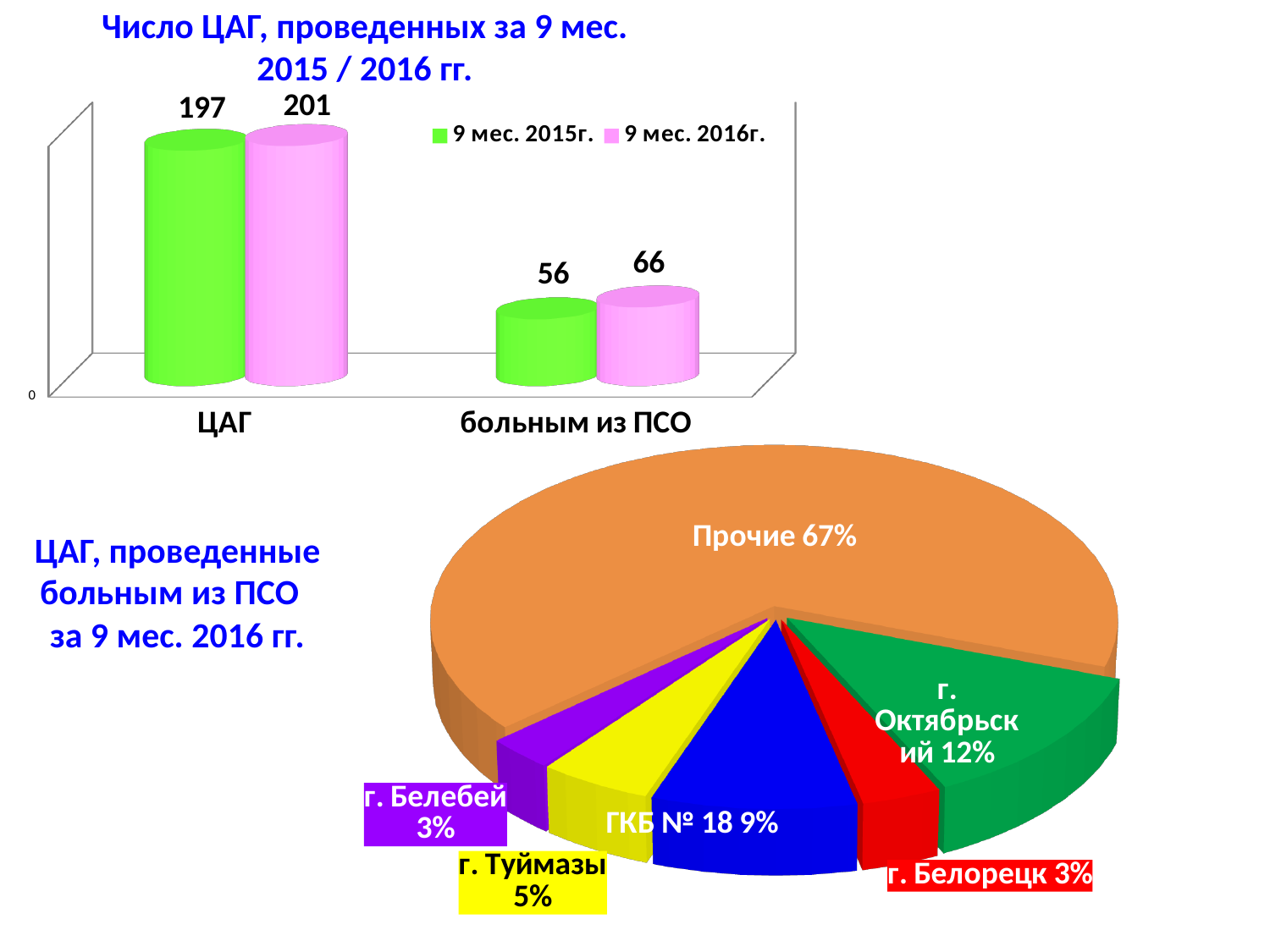
In the pie chart 'ЦАГ, проведенные больным из ПСО за 9 мес. 2016 гг.', what share does 'г. Октябрьский' have? 12% In the bar chart 'Число ЦАГ, проведенных за 9 мес. 2015 / 2016 гг.', which is larger for 'больным из ПСО': the 2015 value or the 2016 value? 9 мес. 2016г. In the bar chart 'Число ЦАГ, проведенных за 9 мес. 2015 / 2016 гг.', what is the value for 'больным из ПСО' in the series '9 мес. 2016г.'? 66 What kind of chart is the top chart 'Число ЦАГ, проведенных за 9 мес. 2015 / 2016 гг.'? Bar chart How many series does the legend of the bar chart 'Число ЦАГ, проведенных за 9 мес. 2015 / 2016 гг.' list? 2 In the pie chart 'ЦАГ, проведенные больным из ПСО за 9 мес. 2016 гг.', what share does 'Прочие' have? 67% How many slices does the pie chart 'ЦАГ, проведенные больным из ПСО за 9 мес. 2016 гг.' have? 6 In the bar chart 'Число ЦАГ, проведенных за 9 мес. 2015 / 2016 гг.', what is the difference between the 2016 and 2015 values for ЦАГ? 4 In the pie chart 'ЦАГ, проведенные больным из ПСО за 9 мес. 2016 гг.', which slice is the largest? Прочие In the bar chart 'Число ЦАГ, проведенных за 9 мес. 2015 / 2016 гг.', what is the difference between the 2016 and 2015 values for 'больным из ПСО'? 10 In the pie chart 'ЦАГ, проведенные больным из ПСО за 9 мес. 2016 гг.', what is the difference between the shares of 'ГКБ № 18' and 'г. Туймазы'? 4% In the bar chart 'Число ЦАГ, проведенных за 9 мес. 2015 / 2016 гг.', what is the value for ЦАГ in the series '9 мес. 2015г.'? 197